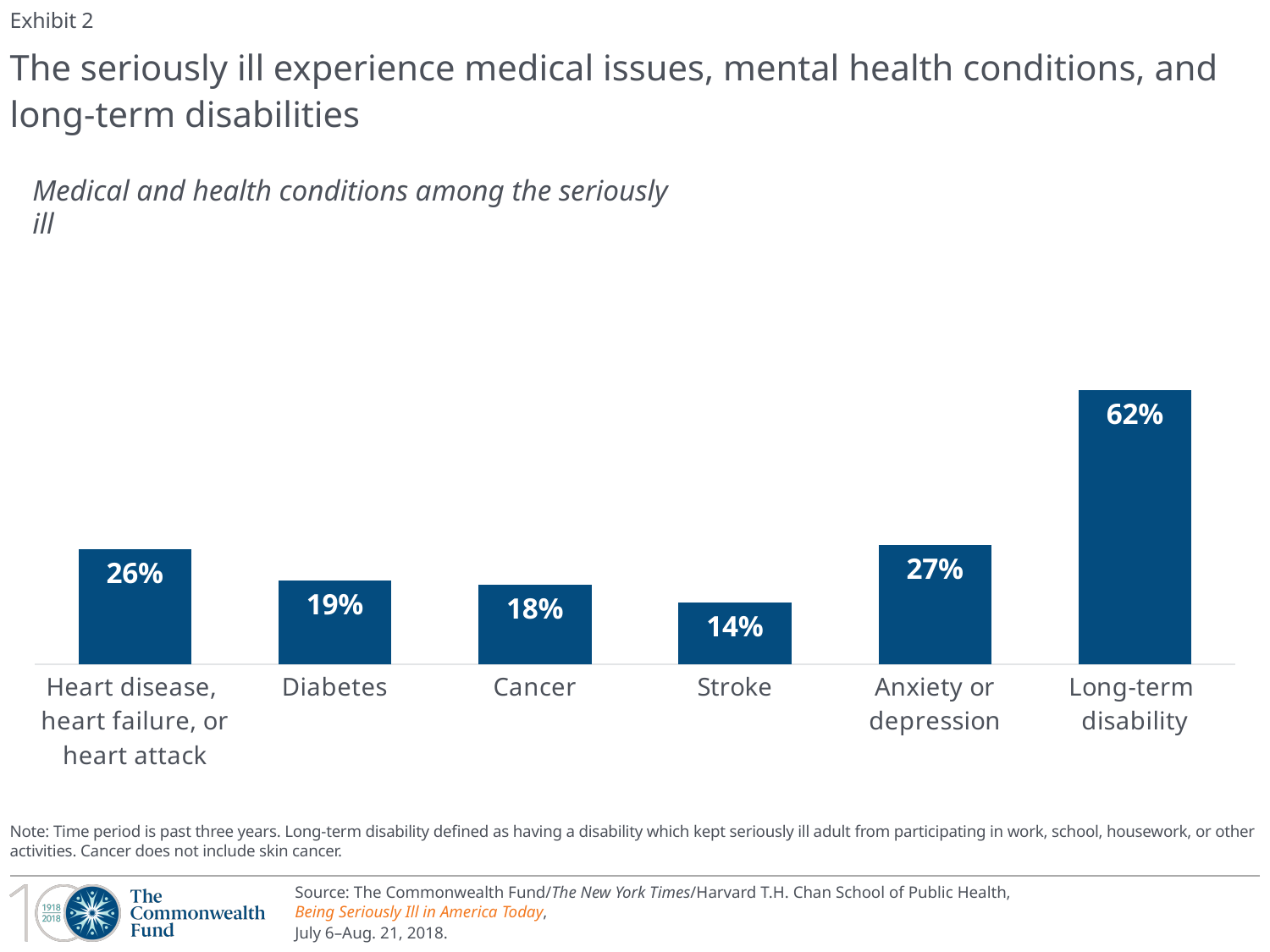
What is the subtitle of the chart? Medical and health conditions among the seriously ill What kind of chart is shown on the slide? Bar chart Which is larger, the value for Anxiety or depression or the value for Heart disease, heart failure, or heart attack? Anxiety or depression What is the difference between the values for Diabetes and Cancer? 1 percentage point What is the value for Stroke? 14% What percentage of the seriously ill have a long-term disability? 62% Which condition has the lowest value? Stroke How many conditions are shown in the chart? 6 What is the value for Anxiety or depression? 27% What is the difference between the values for Long-term disability and Anxiety or depression? 35 percentage points Which condition has the highest value? Long-term disability What is the value for Heart disease, heart failure, or heart attack? 26%